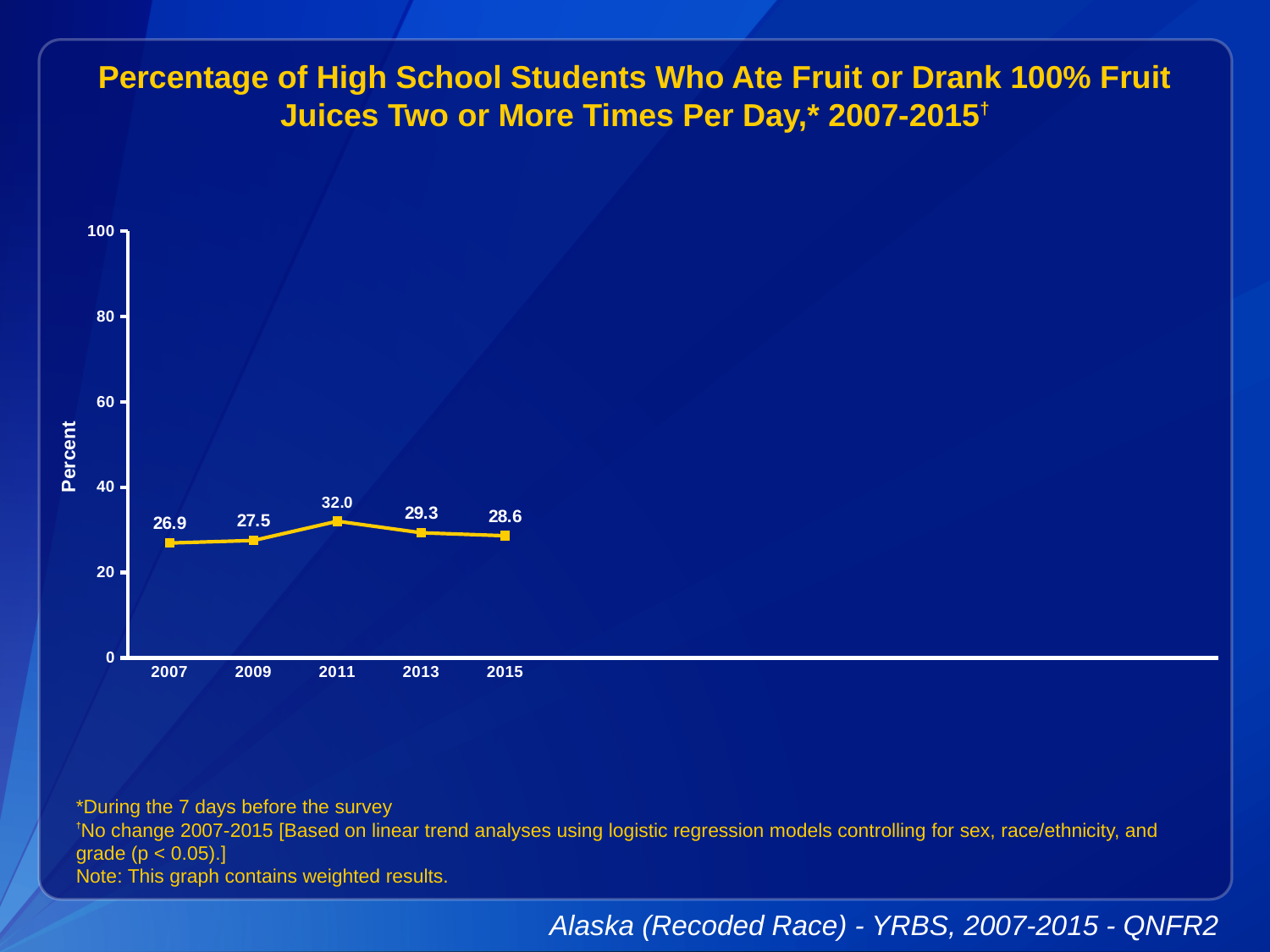
What is the difference between the 2011 value and the 2007 value? 5.1 How many years are plotted on the chart? 5 What kind of chart is shown on the slide? line chart Which year has the lowest value on the chart? 2007 Which year has the larger value, 2013 or 2015? 2013 Which year has the highest value on the chart? 2011 What is the label on the vertical axis? Percent What is the value plotted for 2015? 28.6 What percentage of high school students ate fruit or drank 100% fruit juices two or more times per day in 2007? 26.9 Does the value rise or fall from 2011 to 2015? fall What is the value plotted for 2011? 32.0 Is the value for 2011 greater or less than 40? less